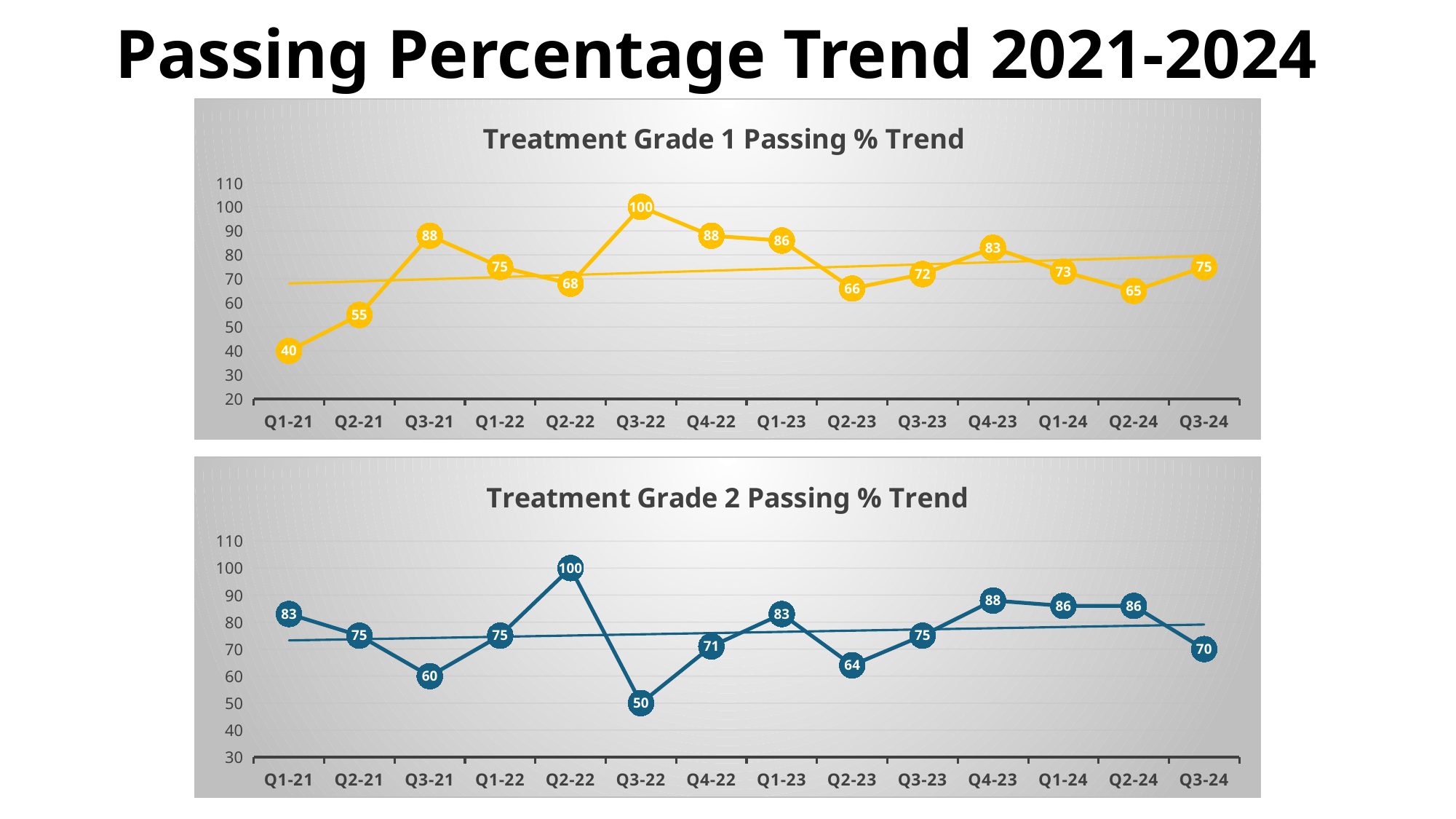
In the 'Treatment Grade 1 Passing % Trend' chart, what is the value for Q1-21? 40 In the 'Treatment Grade 2 Passing % Trend' chart, which quarter has the lowest value? Q3-22 In the 'Treatment Grade 1 Passing % Trend' chart, do the values rise or fall from Q1-21 to Q3-21? Rise In the 'Treatment Grade 2 Passing % Trend' chart, what is the difference between the values for Q4-23 and Q3-24? 18 In the 'Treatment Grade 1 Passing % Trend' chart, what is the difference between the values for Q3-22 and Q2-22? 32 What kind of chart is the 'Treatment Grade 1 Passing % Trend' chart? Line chart In the 'Treatment Grade 2 Passing % Trend' chart, which quarter has the highest value? Q2-22 In the 'Treatment Grade 2 Passing % Trend' chart, what is the value for Q3-22? 50 How many quarters are plotted in the 'Treatment Grade 2 Passing % Trend' chart? 14 In the 'Treatment Grade 1 Passing % Trend' chart, which quarter has the lowest value? Q1-21 In the 'Treatment Grade 1 Passing % Trend' chart, what is the value for Q3-22? 100 In the 'Treatment Grade 1 Passing % Trend' chart, which is larger, the value for Q3-21 or the value for Q2-23? Q3-21